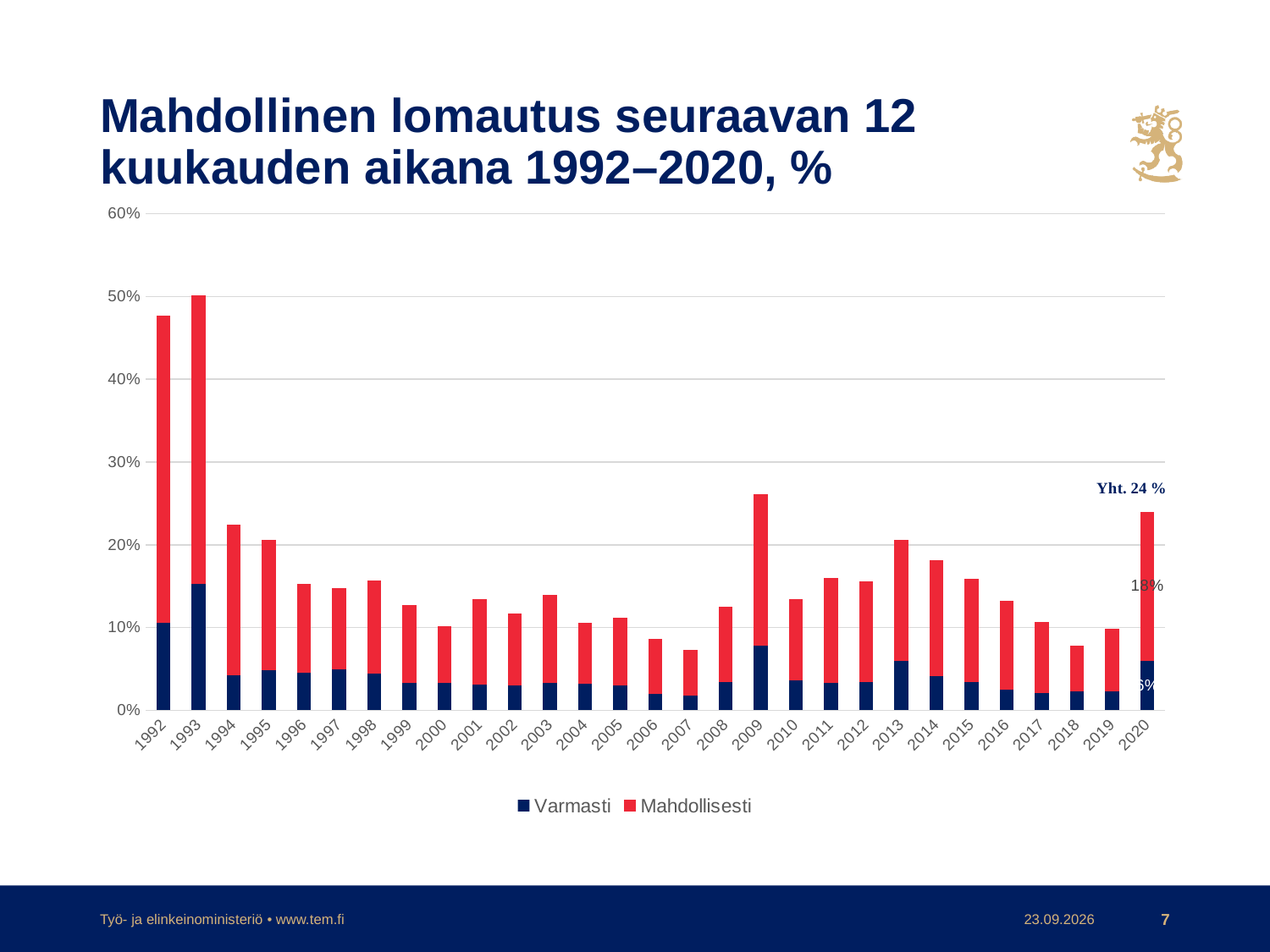
How many years are shown on the x axis? 29 Which year has the highest total stacked bar? 1993 What is the total (Yht.) value of the stacked bar for 2020? 24 % What kind of chart is shown on the slide? bar chart What are the two series named in the legend? Varmasti and Mahdollisesti What is the title of the chart? Mahdollinen lomautus seuraavan 12 kuukauden aikana 1992–2020, % Which year has the larger total stacked bar, 2009 or 2013? 2009 Do the total stacked bars rise or fall from 2005 to 2007? fall How many series does the legend list? 2 Is the total stacked bar for 1993 greater or less than 40%? greater What is the Mahdollisesti value for 2020? 18% Is the total stacked bar for 2009 greater or less than 20%? greater